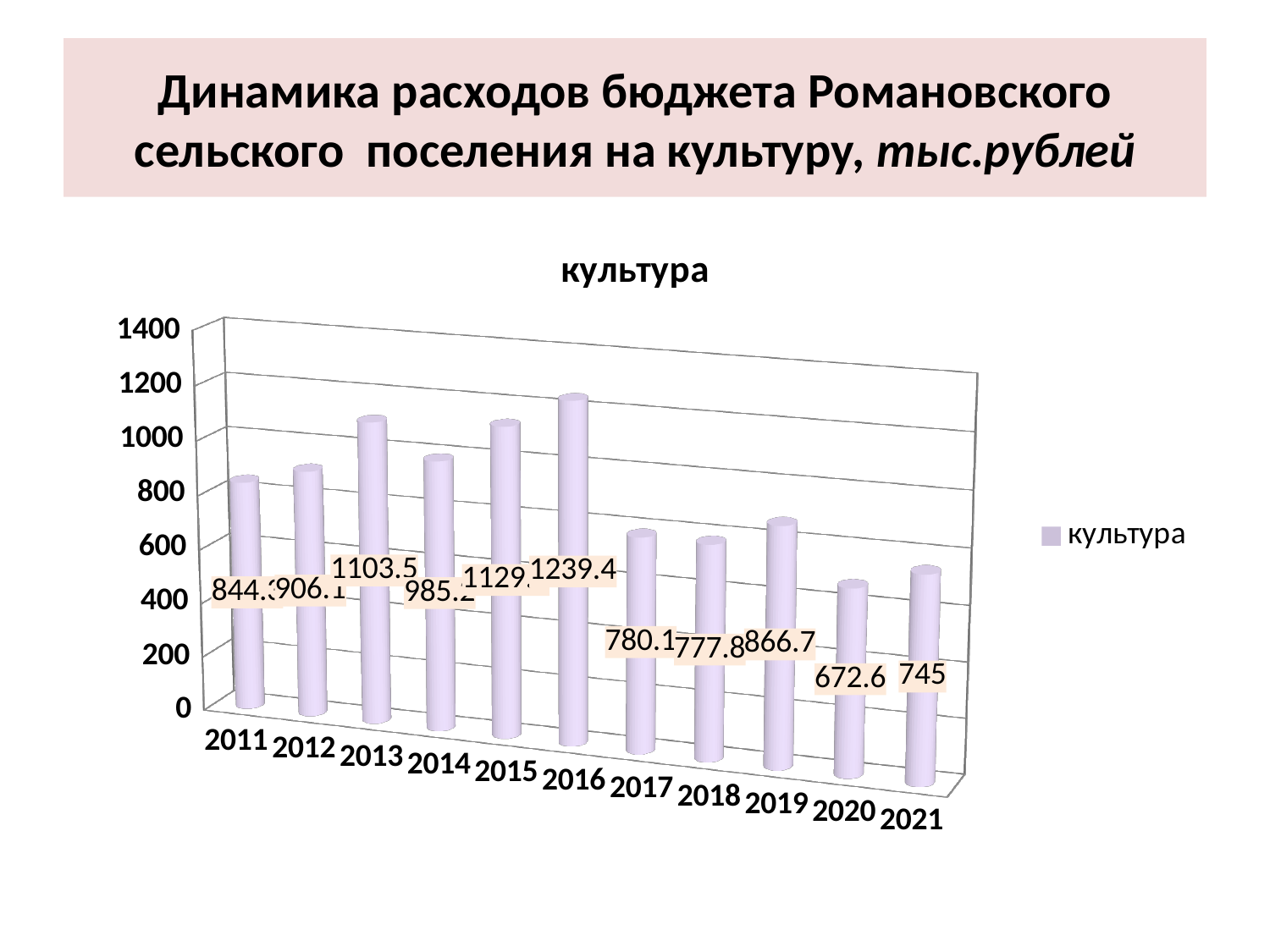
What is the value for 2013? 1103.5 How many years are shown on the x axis? 11 Which year has the highest value? 2016 How many series does the legend list? 1 Which is larger, the value for 2019 or the value for 2018? 2019 What is the value for 2016? 1239.4 Is the value for 2011 greater or less than 800? greater What type of chart is shown on the slide? bar chart Which year has the lowest value? 2020 What is the value for 2020? 672.6 What is the difference between the values for 2013 and 2014? 118.3 What is the value for 2021? 745